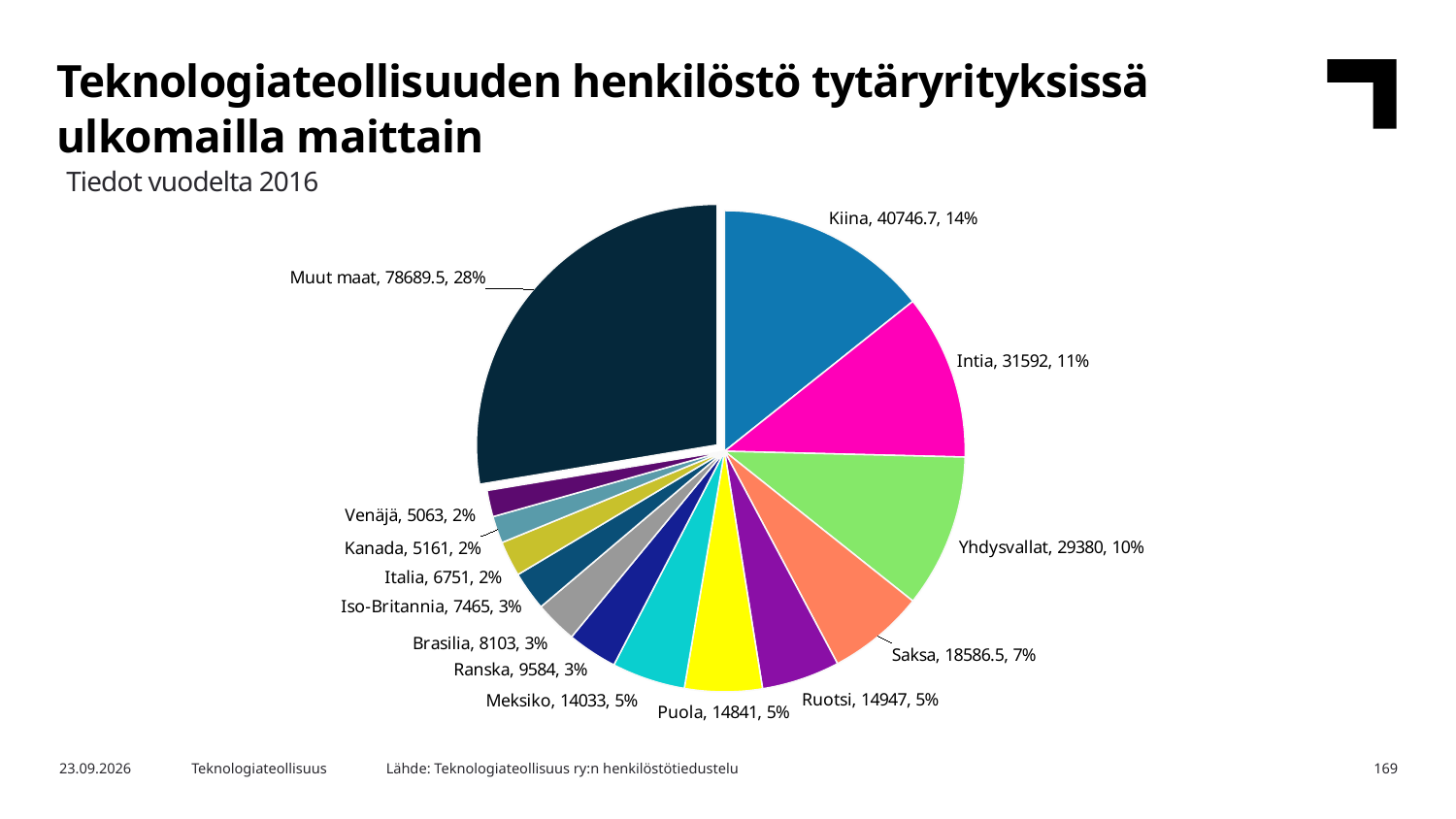
What share of the pie does Intia represent? 11% What is the difference between the values for Kiina and Intia? 9154.7 What is the value for Meksiko? 14033 Which is larger, the value for Yhdysvallat or the value for Saksa? Yhdysvallat What type of chart is shown on the slide? Pie chart Which category has the smallest slice of the pie? Venäjä What year does the data on the slide come from? 2016 What is the value for Saksa? 18586.5 Which category has the largest slice of the pie? Muut maat What share of the pie does Muut maat represent? 28% How many categories are shown in the pie chart? 14 What is the value for Kiina? 40746.7